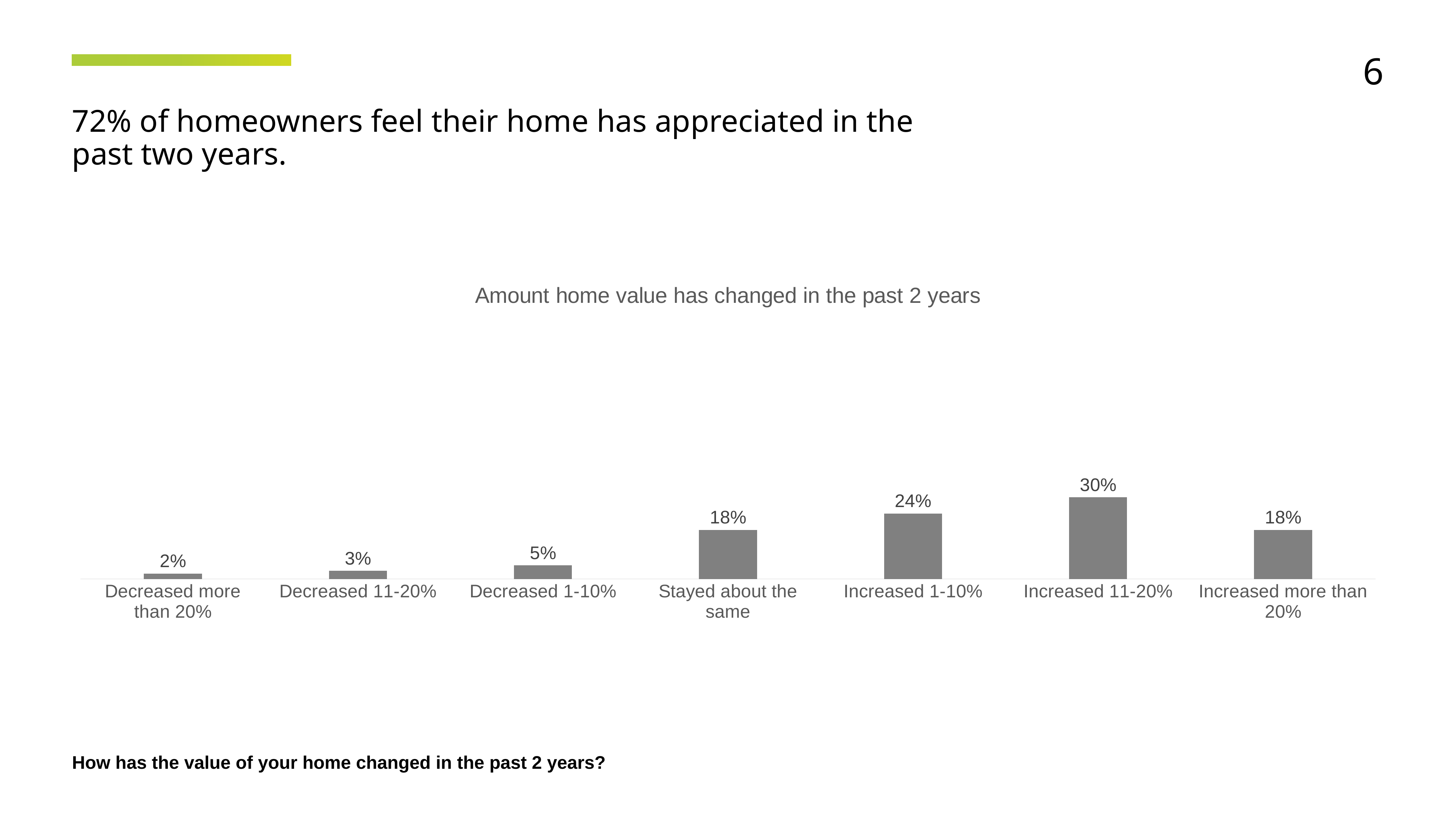
How many categories are shown on the x axis? 7 Which category has the lowest value? Decreased more than 20% What is the value for "Increased 1-10%"? 24% What is the value for "Decreased 1-10%"? 5% Which category has the highest value? Increased 11-20% What is the value for "Stayed about the same"? 18% Which is larger, the value for "Increased 1-10%" or the value for "Increased more than 20%"? Increased 1-10% What is the title of the chart? Amount home value has changed in the past 2 years What is the difference between the values for "Increased 11-20%" and "Increased 1-10%"? 6% What is the value for "Increased 11-20%"? 30% What is the combined value of "Decreased more than 20%", "Decreased 11-20%" and "Decreased 1-10%"? 10% What kind of chart is shown on the slide? Bar chart